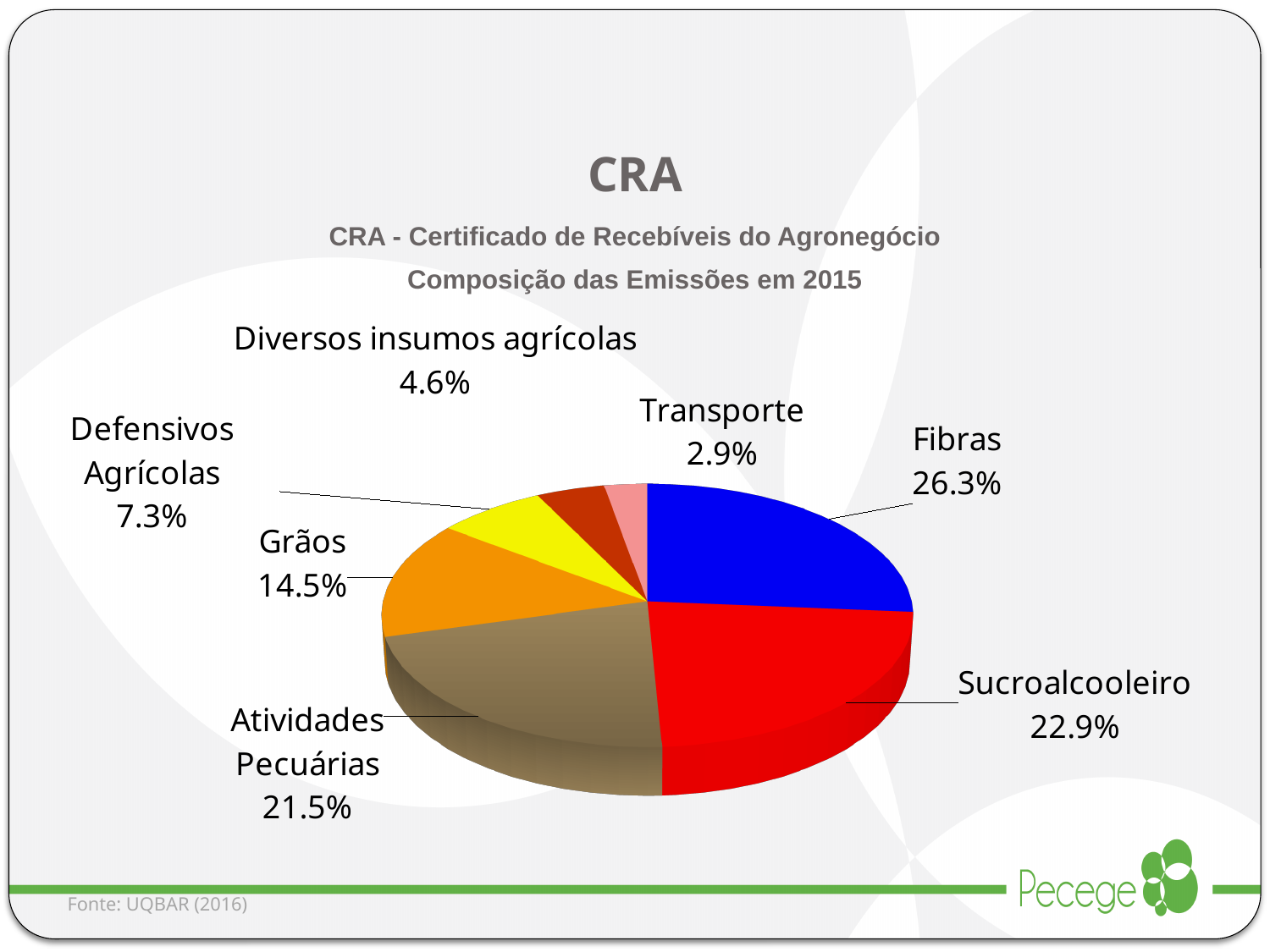
Which category has the smallest slice of the pie? Transporte What share of the pie does Fibras represent? 26.3% Which is larger, Grãos or Defensivos Agrícolas? Grãos What share is shown for Transporte? 2.9% What is the value for Grãos? 14.5% What percentage is labelled for Atividades Pecuárias? 21.5% What colour is the Sucroalcooleiro slice? Red What type of chart is shown on the slide? Pie chart Which category has the largest slice of the pie? Fibras What is the value shown for Sucroalcooleiro? 22.9% What is the difference between the shares of Fibras and Sucroalcooleiro? 3.4% How many categories are shown in the pie chart? 7